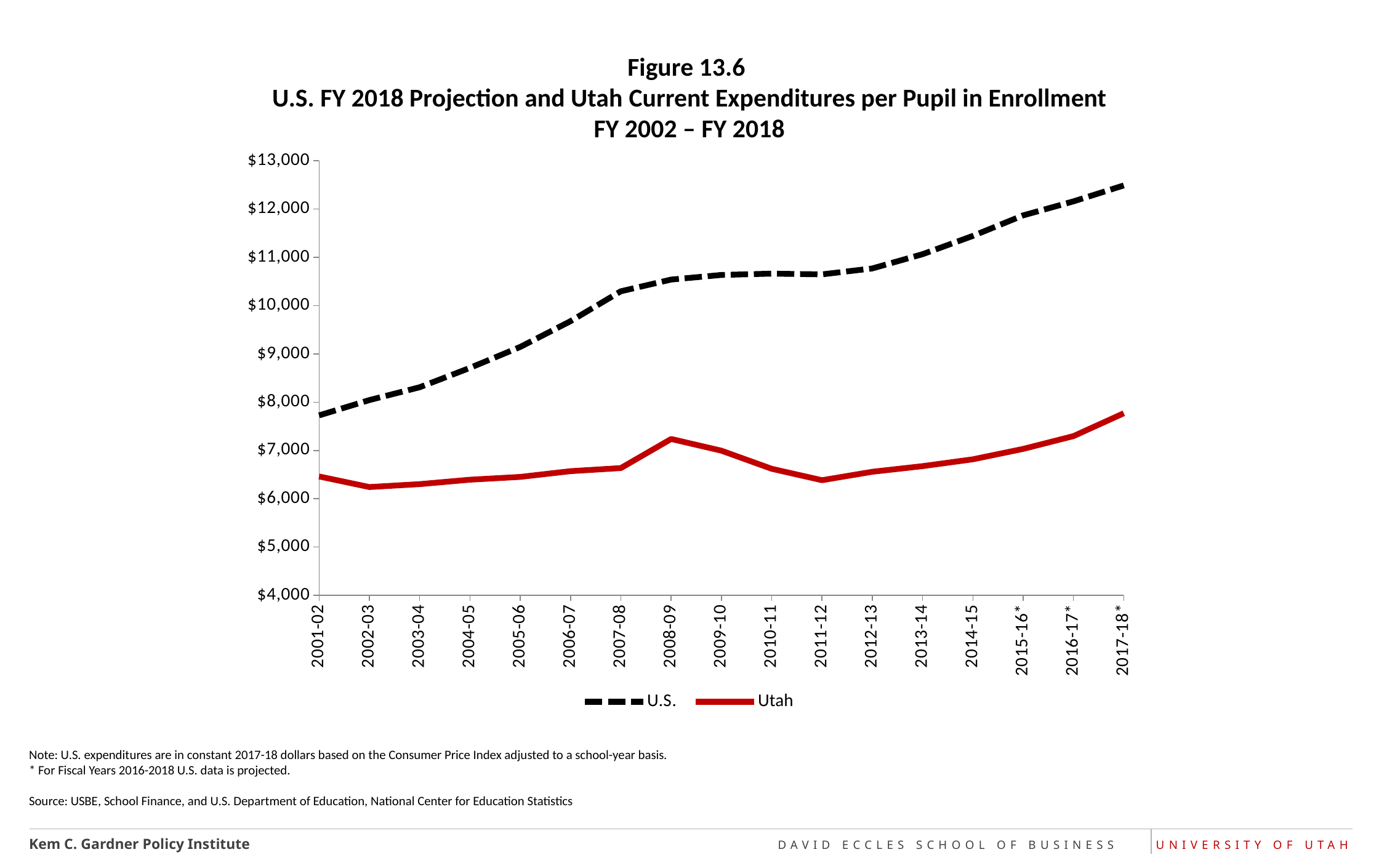
How many fiscal years are plotted along the x axis? 17 What kind of chart is shown on the slide? line chart Which series is drawn with a dashed black line? U.S. Is the U.S. value for 2001-02 greater or less than $8,000? less In which fiscal year is the U.S. value lowest? 2001-02 Is the Utah value for 2008-09 greater or less than $7,000? greater Does the U.S. series generally rise or fall from 2001-02 to 2017-18? rise In 2010-11, which series has the larger value, U.S. or Utah? U.S. In which fiscal year is the Utah value highest? 2017-18* How many series does the legend list? 2 Is the U.S. value for 2017-18 greater or less than $12,000? greater In which fiscal year is the U.S. value highest? 2017-18*